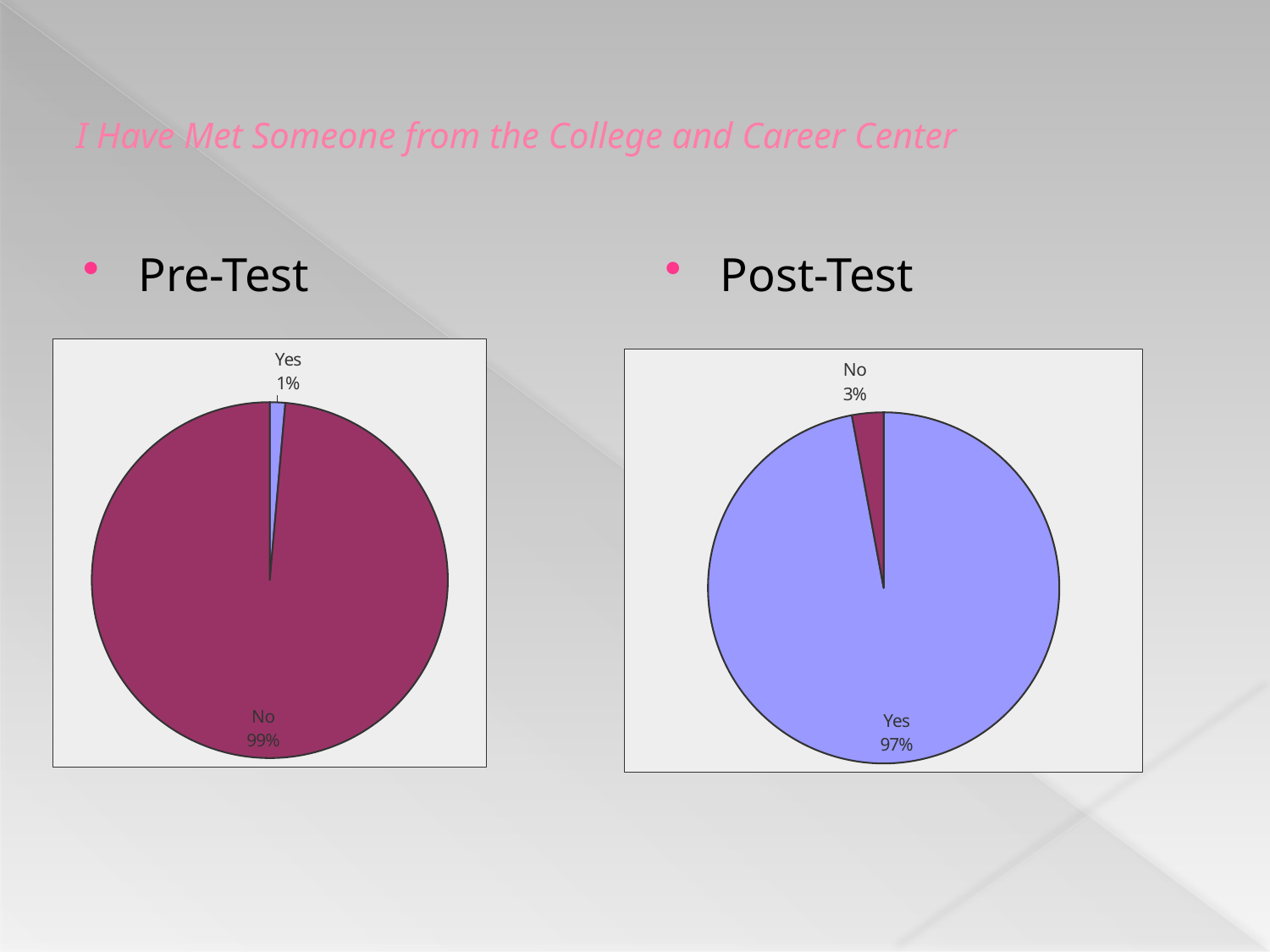
In the Pre-Test pie chart, which response has the largest share? No In the Post-Test pie chart, what colour is the Yes slice? Light blue/purple What is the title of the slide containing the two pie charts? I Have Met Someone from the College and Career Center In the Post-Test pie chart, what percentage answered Yes? 97% In the Pre-Test pie chart, what percentage answered No? 99% In the Pre-Test pie chart, what percentage answered Yes? 1% How many slices does the Pre-Test pie chart have? 2 Which is larger: the Yes share in the Pre-Test chart or the Yes share in the Post-Test chart? Post-Test In the Post-Test pie chart, which response has the smallest share? No What type of chart is used for the Post-Test data? Pie chart In the Post-Test pie chart, what is the difference between the Yes and No shares? 94% In the Post-Test pie chart, what percentage answered No? 3%